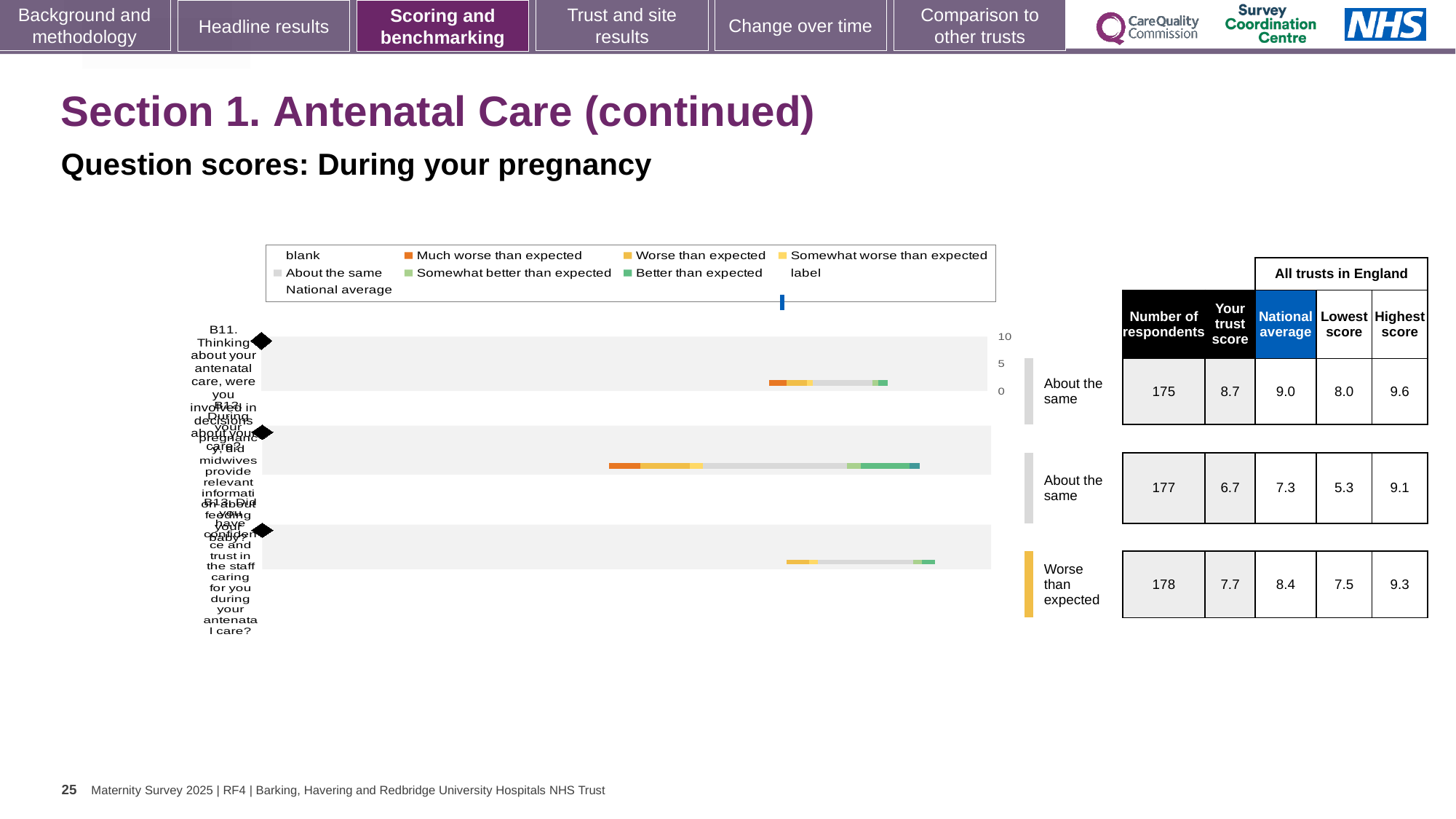
Which row is rated 'Worse than expected'? the third row (B13) What is the national average for the third row (B13)? 8.4 What is the highest score across all trusts in England for the top row (B11)? 9.6 How many survey questions (rows) are plotted in the benchmark chart? 3 What is the number of respondents for the top row (B11, involved in decisions about your care)? 175 For the second row (B12), what is the difference between the national average and your trust score? 0.6 For the top row (B11), is your trust score higher or lower than the national average? lower What is the lowest score across all trusts in England for the second row (B12)? 5.3 In the chart legend, what colour represents 'Much worse than expected'? orange Which row has the lowest 'Your trust score'? B12 (second row) What is 'Your trust score' for the second row (B12)? 6.7 What kind of chart is used to show the question scores? bar chart